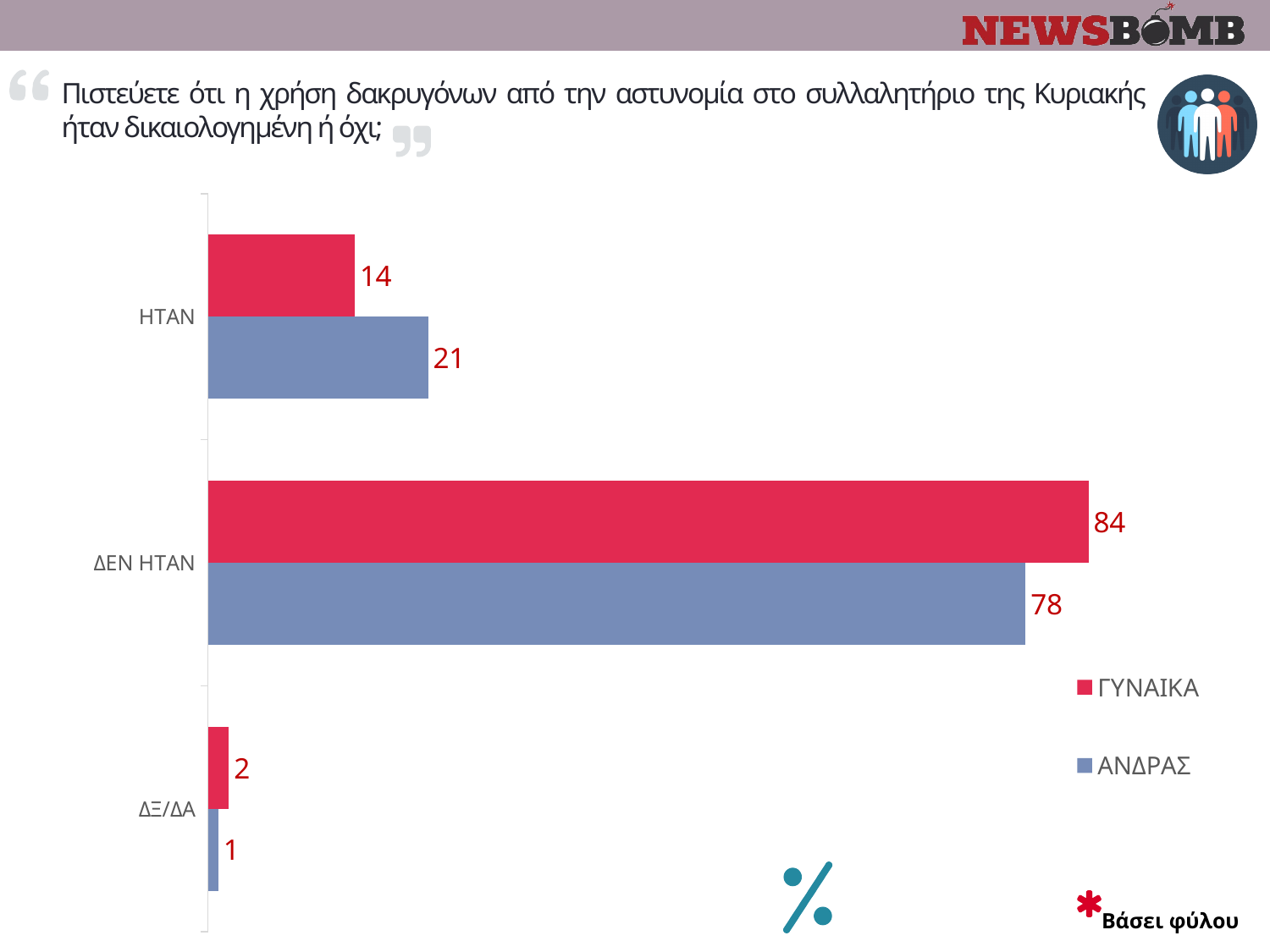
What kind of chart is shown on the slide? bar chart In the ΗΤΑΝ category, which series has the larger value, ΓΥΝΑΙΚΑ or ΑΝΔΡΑΣ? ΑΝΔΡΑΣ What is the value for ΓΥΝΑΙΚΑ in the ΗΤΑΝ category? 14 What is the value for ΑΝΔΡΑΣ in the ΔΕΝ ΗΤΑΝ category? 78 What is the value for ΓΥΝΑΙΚΑ in the ΔΞ/ΔΑ category? 2 How many series does the legend list? 2 What is the difference between the ΓΥΝΑΙΚΑ and ΑΝΔΡΑΣ values in the ΔΕΝ ΗΤΑΝ category? 6 Which category has the lowest value for ΑΝΔΡΑΣ? ΔΞ/ΔΑ Which category has the highest value for ΓΥΝΑΙΚΑ? ΔΕΝ ΗΤΑΝ Which colour represents the ΓΥΝΑΙΚΑ series? red How many categories are shown on the chart? 3 What is the value for ΑΝΔΡΑΣ in the ΗΤΑΝ category? 21